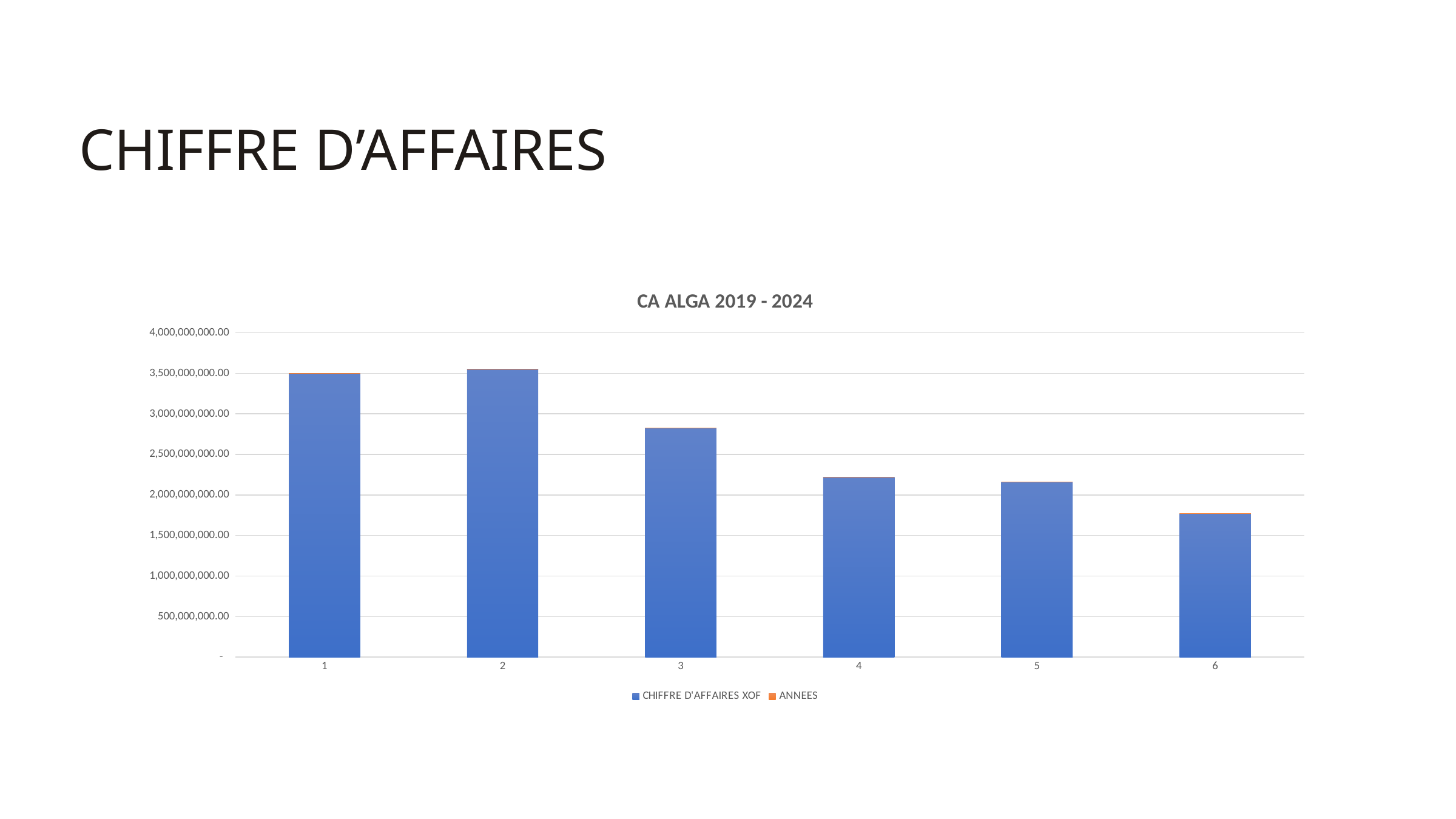
What kind of chart is shown on the slide? bar chart Which is larger, the value for category 3 or the value for category 4? category 3 Is the value for category 3 greater or less than 2,500,000,000.00? greater Which category has the lowest bar in the chart? 6 How many series does the chart legend list? 2 Which series is shown in blue in the chart legend? CHIFFRE D'AFFAIRES XOF How many categories are shown on the x axis of the chart? 6 Do the values generally rise or fall from category 1 to category 6? fall Is the value for category 6 greater or less than 2,000,000,000.00? less What is the title of the chart? CA ALGA 2019 - 2024 Is the value for category 4 greater or less than 2,500,000,000.00? less